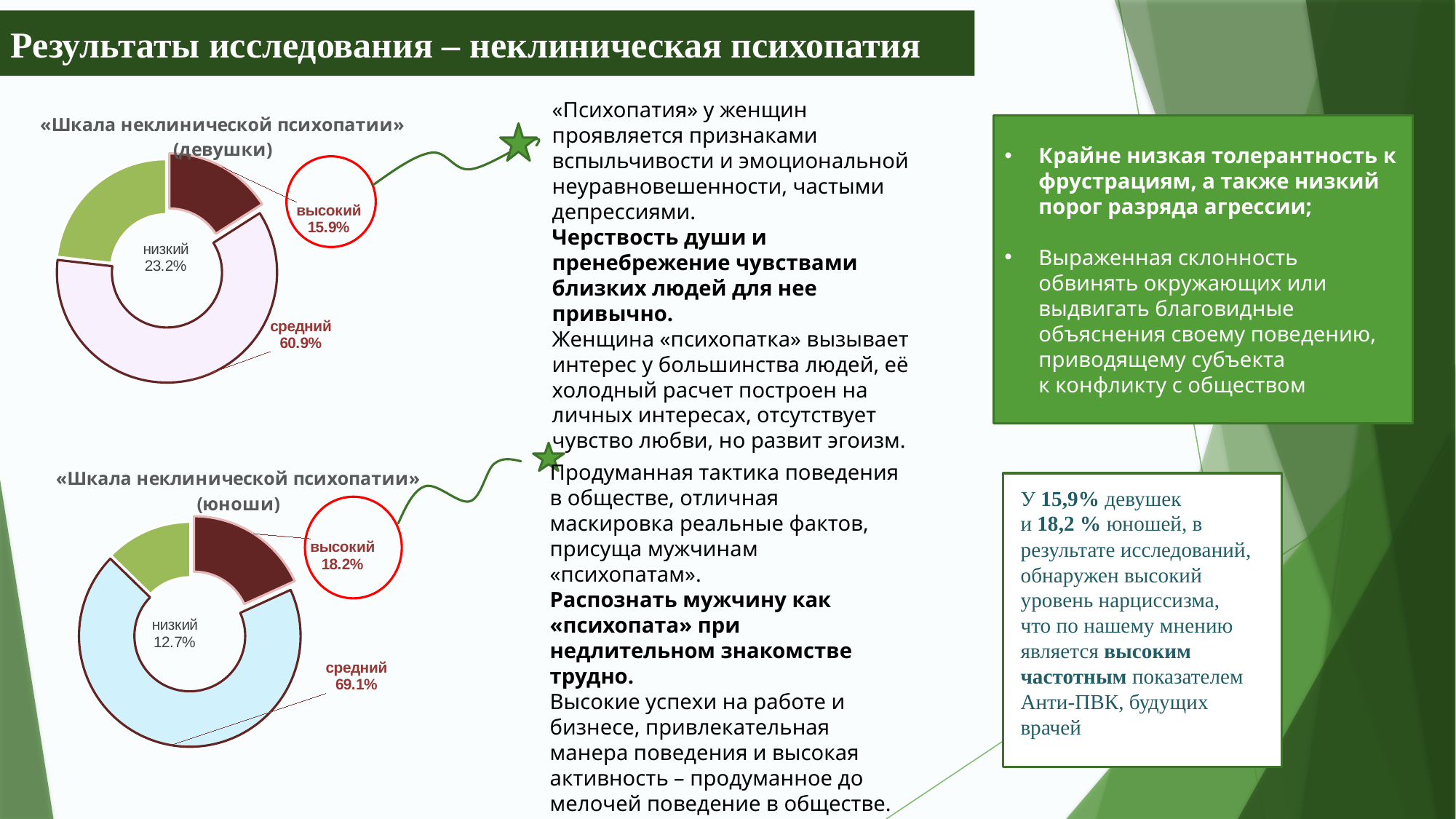
How many categories are shown in the chart «Шкала неклинической психопатии» (девушки)? 3 In the chart «Шкала неклинической психопатии» (юноши), what is the value for the «низкий» category? 12.7% In the chart «Шкала неклинической психопатии» (девушки), which category has the largest share? средний In the chart «Шкала неклинической психопатии» (юноши), what is the value for the «высокий» category? 18.2% In the chart «Шкала неклинической психопатии» (юноши), which category has the smallest share? низкий In the chart «Шкала неклинической психопатии» (девушки), what is the value for the «низкий» category? 23.2% In the chart «Шкала неклинической психопатии» (девушки), what is the value for the «высокий» category? 15.9% In the chart «Шкала неклинической психопатии» (юноши), what is the value for the «средний» category? 69.1% In the chart «Шкала неклинической психопатии» (девушки), what is the value for the «средний» category? 60.9% Which is larger: the «высокий» value in the девушки chart or the «высокий» value in the юноши chart? юноши (18.2%) What is the difference between the «средний» and «низкий» values in the chart «Шкала неклинической психопатии» (юноши)? 56.4% What type of chart is used for «Шкала неклинической психопатии» (юноши)? Doughnut chart